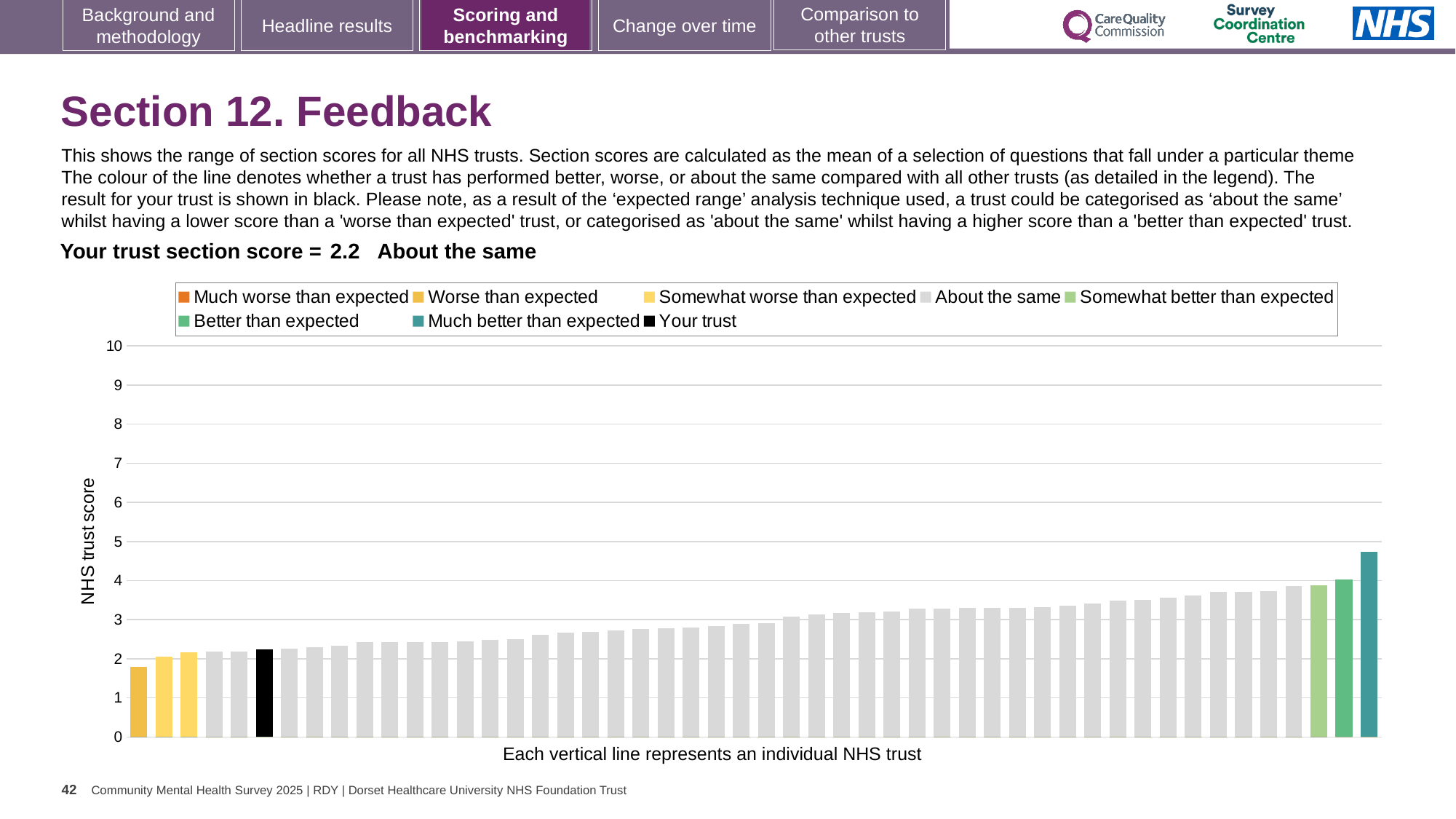
Which legend category does the tallest bar belong to? Much better than expected Which legend category does the shortest bar belong to? Worse than expected What is the label on the vertical axis of the chart? NHS trust score Is the value of the tallest bar greater or less than 4? greater Do the bar values rise or fall from left to right along the x axis? Rise How many entries does the chart legend list? 8 What is the section score for your trust, as printed on the slide? 2.2 What kind of chart is shown on the slide? Bar chart Is the value of the shortest bar greater or less than 2? less Which category is your trust placed in for this section, according to the text above the chart? About the same Is the value of the black 'Your trust' bar greater or less than 3? less Is the 'Your trust' bar taller or shorter than the leftmost bar? Taller